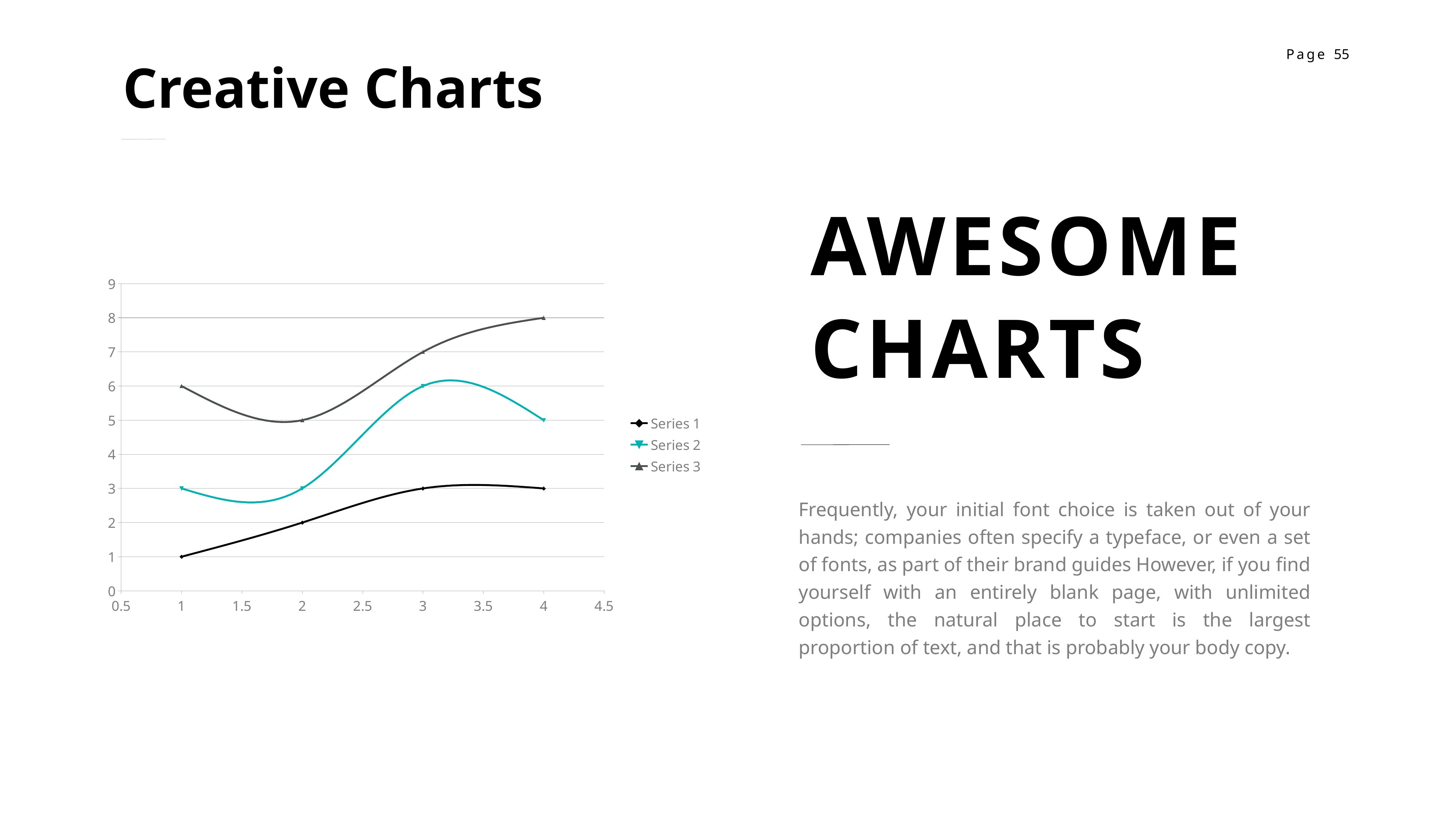
What is the value of Series 3 at x = 4? 8 What is the difference between Series 3 and Series 1 at x = 4? 5 What kind of chart is shown on the slide? line chart At which x value does Series 1 have its lowest value? 1 Which series is drawn in teal? Series 2 What is the value of Series 1 at x = 1? 1 How many data points are plotted for Series 2? 4 At which x value does Series 3 reach its highest point? 4 Does Series 1 generally rise or fall from x = 1 to x = 3? rise At x = 2, which is larger: Series 2 or Series 3? Series 3 How many series does the legend list? 3 What is the value of Series 2 at x = 3? 6